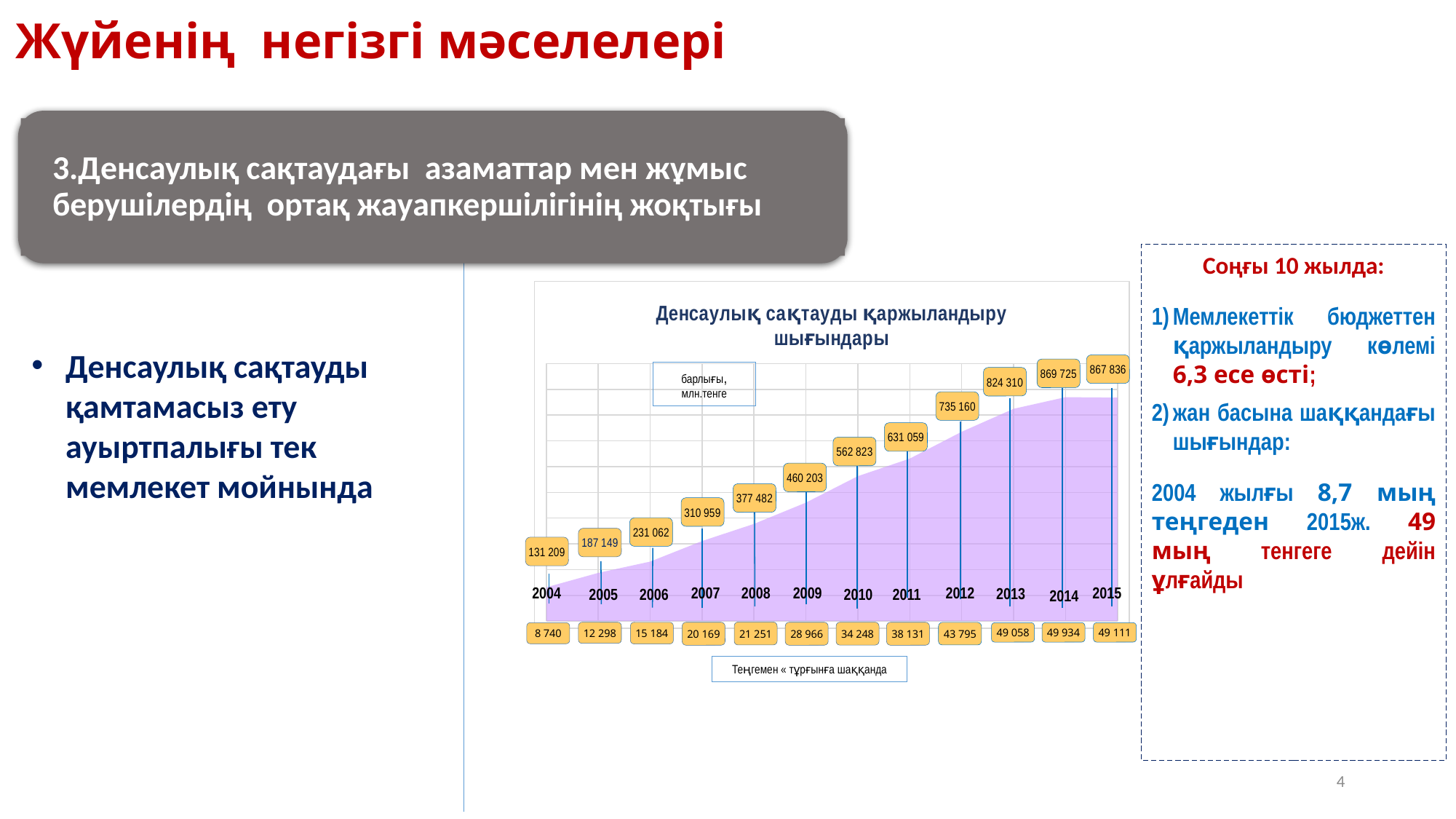
Which is larger, the total value for 2008 or for 2009? 2009 What is the per-capita value (Теңгемен тұрғынға шаққанда) for 2004? 8 740 How many years are plotted on the x axis of the chart? 12 What kind of chart is shown on the slide? area chart What is the total value (барлығы, млн.тенге) for 2004? 131 209 What is the title of the chart? Денсаулық сақтауды қаржыландыру шығындары Which year has the highest total value (барлығы, млн.тенге)? 2014 What is the total value (барлығы, млн.тенге) for 2010? 562 823 Which year has the lowest total value (барлығы, млн.тенге)? 2004 What is the total value (барлығы, млн.тенге) for 2015? 867 836 What is the difference between the total values for 2013 and 2012? 89 150 What is the per-capita value (Теңгемен тұрғынға шаққанда) for 2014? 49 934